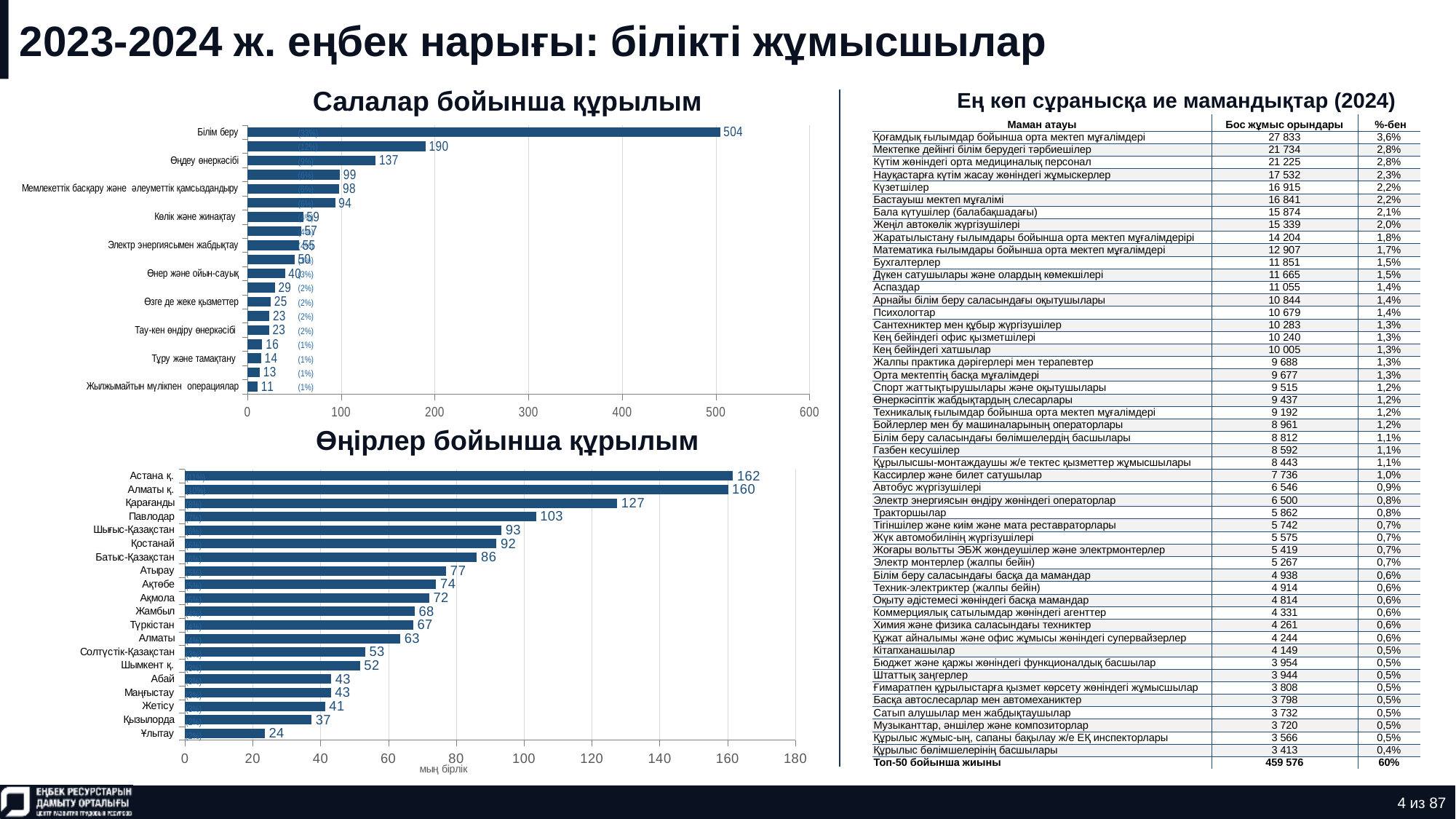
In the 'Өңірлер бойынша құрылым' chart, which region has the lowest value? Ұлытау In the 'Өңірлер бойынша құрылым' chart, how many regions are shown? 20 In the 'Өңірлер бойынша құрылым' chart, what is the value for Қарағанды? 127 In the 'Салалар бойынша құрылым' chart, what is the difference between Білім беру and Өңдеу өнеркәсібі? 367 What unit is shown on the x axis of the 'Өңірлер бойынша құрылым' chart? мың бірлік In the 'Өңірлер бойынша құрылым' chart, which region has the highest value? Астана қ. In the 'Салалар бойынша құрылым' chart, which is larger: Көлік және жинақтау or Электр энергиясымен жабдықтау? Көлік және жинақтау What kind of chart is 'Салалар бойынша құрылым'? Bar chart In the 'Салалар бойынша құрылым' chart, which category has the lowest value? Жылжымайтын мүлікпен операциялар In the 'Салалар бойынша құрылым' chart, what is the value for Өңдеу өнеркәсібі? 137 In the 'Салалар бойынша құрылым' chart, what is the value for Білім беру? 504 In the 'Өңірлер бойынша құрылым' chart, what is the difference between Павлодар and Шығыс-Қазақстан? 10